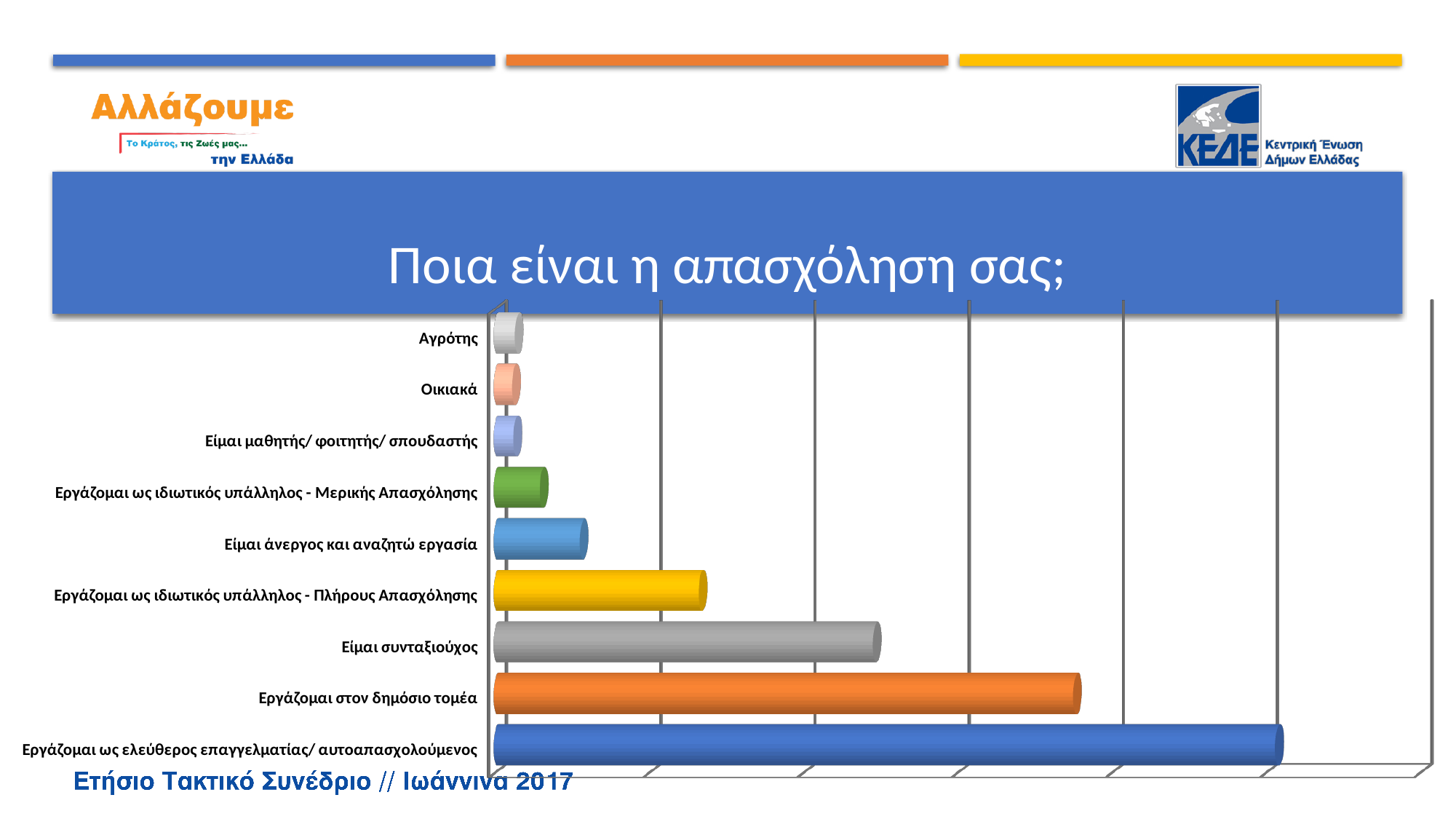
Which is larger, the value for 'Είμαι άνεργος και αναζητώ εργασία' or for 'Εργάζομαι ως ιδιωτικός υπάλληλος - Μερικής Απασχόλησης'? Είμαι άνεργος και αναζητώ εργασία How many categories are plotted in the chart? 9 Which category has the highest value? Εργάζομαι ως ελεύθερος επαγγελματίας/ αυτοαπασχολούμενος Which is larger, the value for 'Εργάζομαι στον δημόσιο τομέα' or for 'Είμαι συνταξιούχος'? Εργάζομαι στον δημόσιο τομέα What kind of chart is shown on the slide? bar chart Which category has the second-longest bar? Εργάζομαι στον δημόσιο τομέα What colour is the bar for 'Εργάζομαι στον δημόσιο τομέα'? orange What is the title of the chart? Ποια είναι η απασχόληση σας; Which is larger, the value for 'Είμαι συνταξιούχος' or for 'Εργάζομαι ως ιδιωτικός υπάλληλος - Πλήρους Απασχόλησης'? Είμαι συνταξιούχος